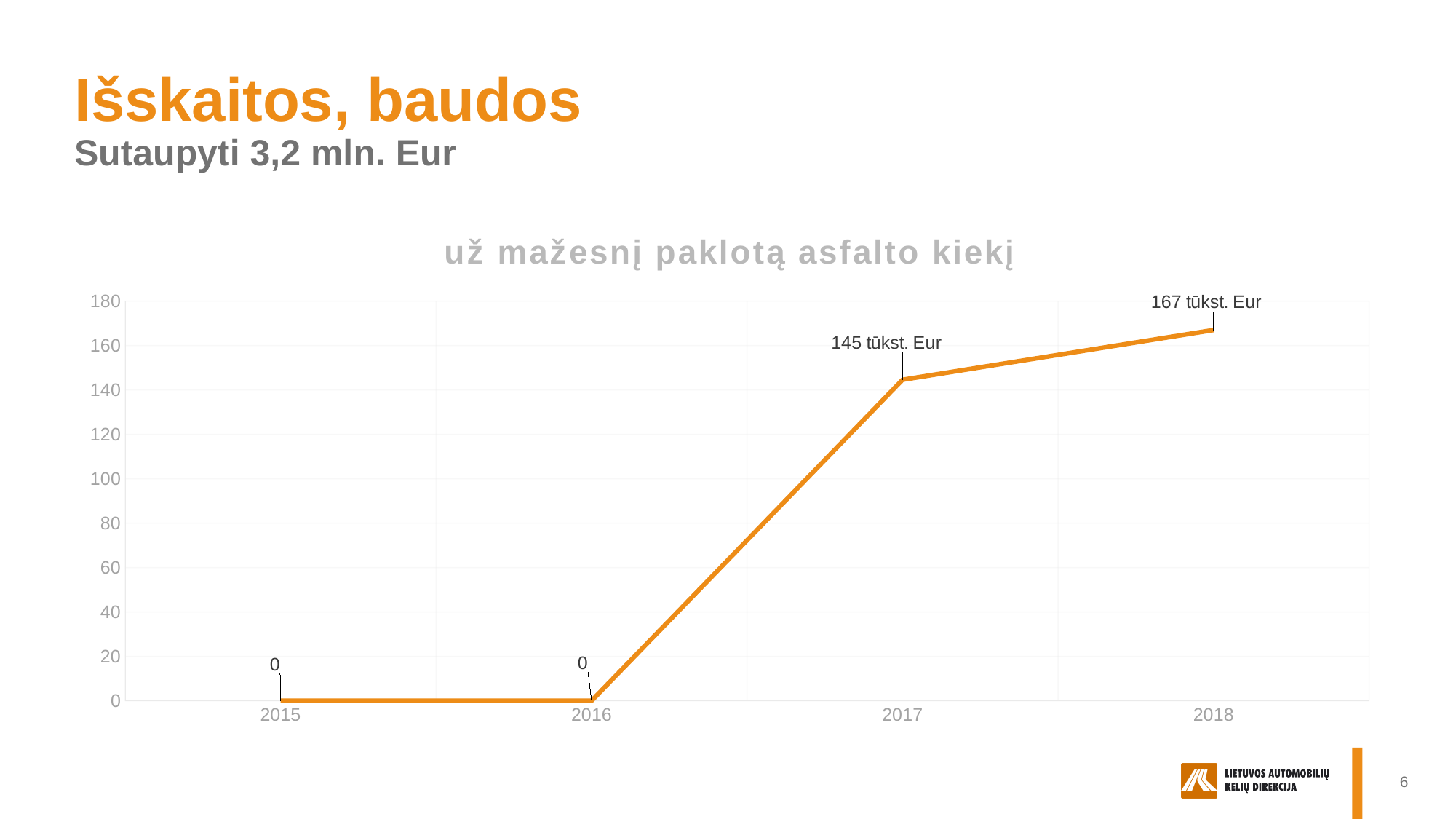
What is the value for 2018? 167 tūkst. Eur What kind of chart is shown on the slide? line chart What is the value for 2016? 0 Is the value for 2017 greater or less than 140? greater Do the values rise or fall from 2016 to 2018? rise How many years are shown on the x axis? 4 Which is larger, the value for 2017 or the value for 2018? 2018 What is the difference between the values for 2018 and 2017? 22 tūkst. Eur Which year has the highest value? 2018 What is the value for 2015? 0 What is the title of the chart? už mažesnį paklotą asfalto kiekį What is the value for 2017? 145 tūkst. Eur